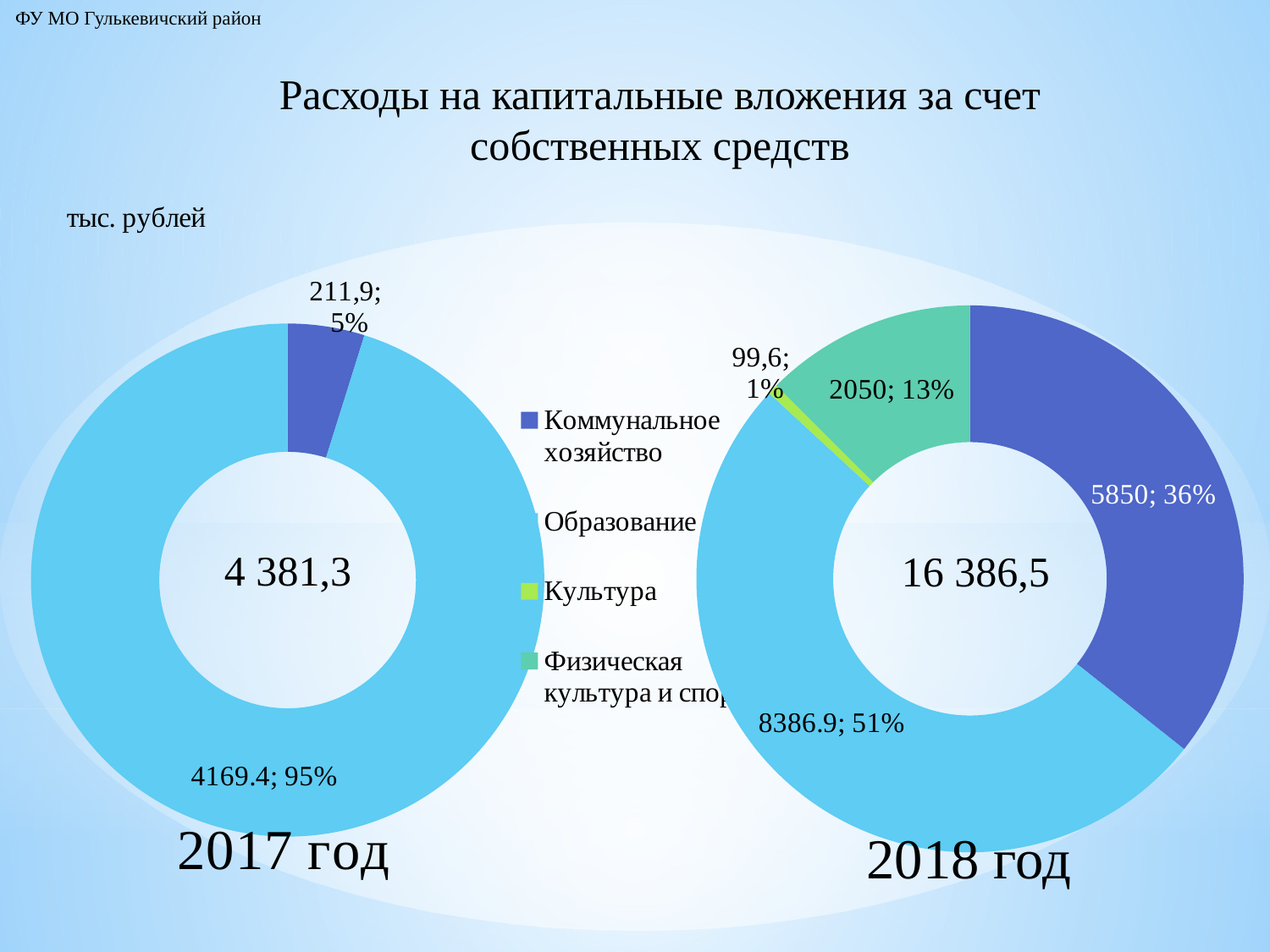
How many series does the legend list? 4 On the 2018 год chart, which category has the smallest value? Культура On the 2018 год chart, what value is shown for Коммунальное хозяйство? 5850 On the 2018 год chart, which is larger: Коммунальное хозяйство or Физическая культура и спорт? Коммунальное хозяйство On the 2017 год chart, what value is shown for Коммунальное хозяйство? 211,9 On the 2017 год chart, what value is shown for Образование? 4169.4 On the 2018 год chart, which category has the largest value? Образование On the 2018 год chart, what share of the total does Физическая культура и спорт represent? 13% On the 2017 год chart, what share of the total does Образование represent? 95% On the 2018 год chart, what value is shown for Культура? 99,6 What type of chart is the 2017 год chart? Doughnut chart What total is shown in the centre of the 2018 год chart? 16 386,5